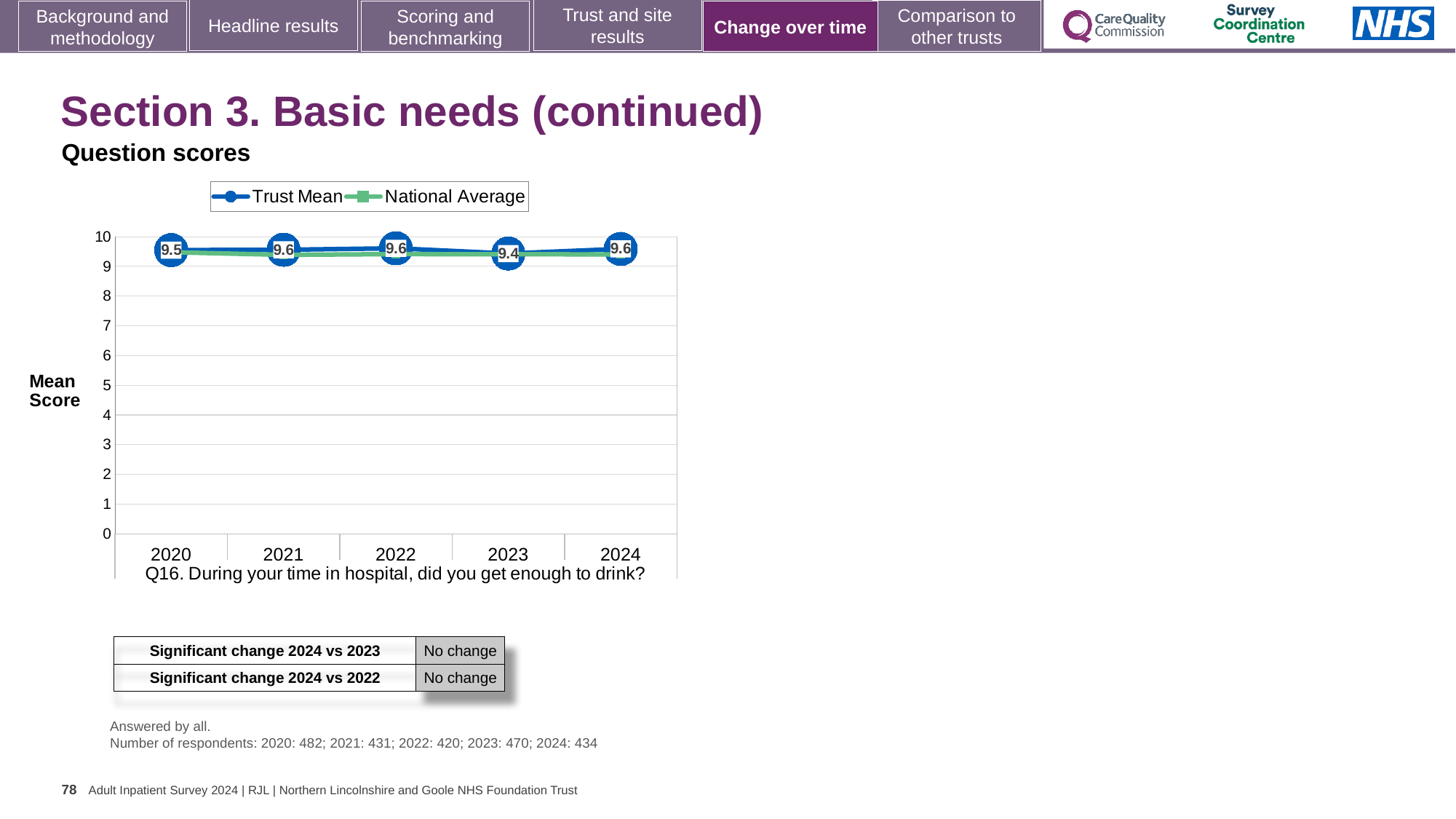
What kind of chart is shown on the slide? Line chart What is the Trust Mean score for 2024? 9.6 Which is larger, the Trust Mean score for 2021 or for 2023? 2021 Is the National Average value for 2022 greater or less than 9? greater What is the Trust Mean score for 2020? 9.5 What is the Trust Mean score for 2023? 9.4 Does the Trust Mean score rise or fall from 2023 to 2024? Rise What is the label on the y axis of the chart? Mean Score How many years are plotted on the x axis? 5 How many series does the legend list? 2 In which year is the Trust Mean score lowest? 2023 What is the difference between the Trust Mean scores for 2024 and 2023? 0.2